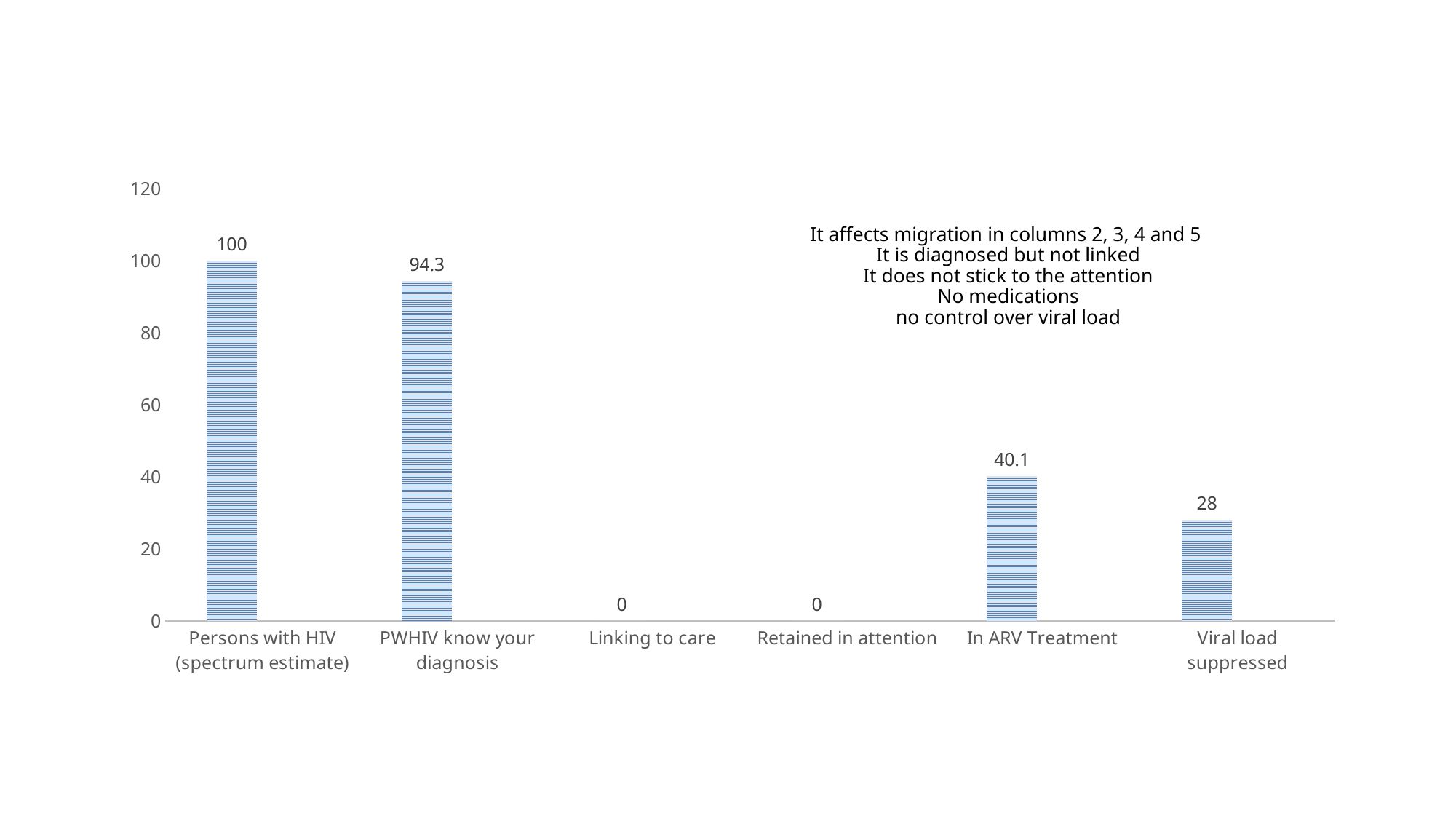
What is the value for Persons with HIV (spectrum estimate)? 100 How many categories have a value of 0? 2 Which is larger, the value for In ARV Treatment or the value for Viral load suppressed? In ARV Treatment What is the value for Viral load suppressed? 28 What is the value for PWHIV know your diagnosis? 94.3 What is the difference between the values for In ARV Treatment and Viral load suppressed? 12.1 What kind of chart is this? bar chart What is the value for Linking to care? 0 Which category has the highest value? Persons with HIV (spectrum estimate) What is the value for In ARV Treatment? 40.1 How many categories are shown on the x axis? 6 What is the difference between the values for Persons with HIV (spectrum estimate) and PWHIV know your diagnosis? 5.7